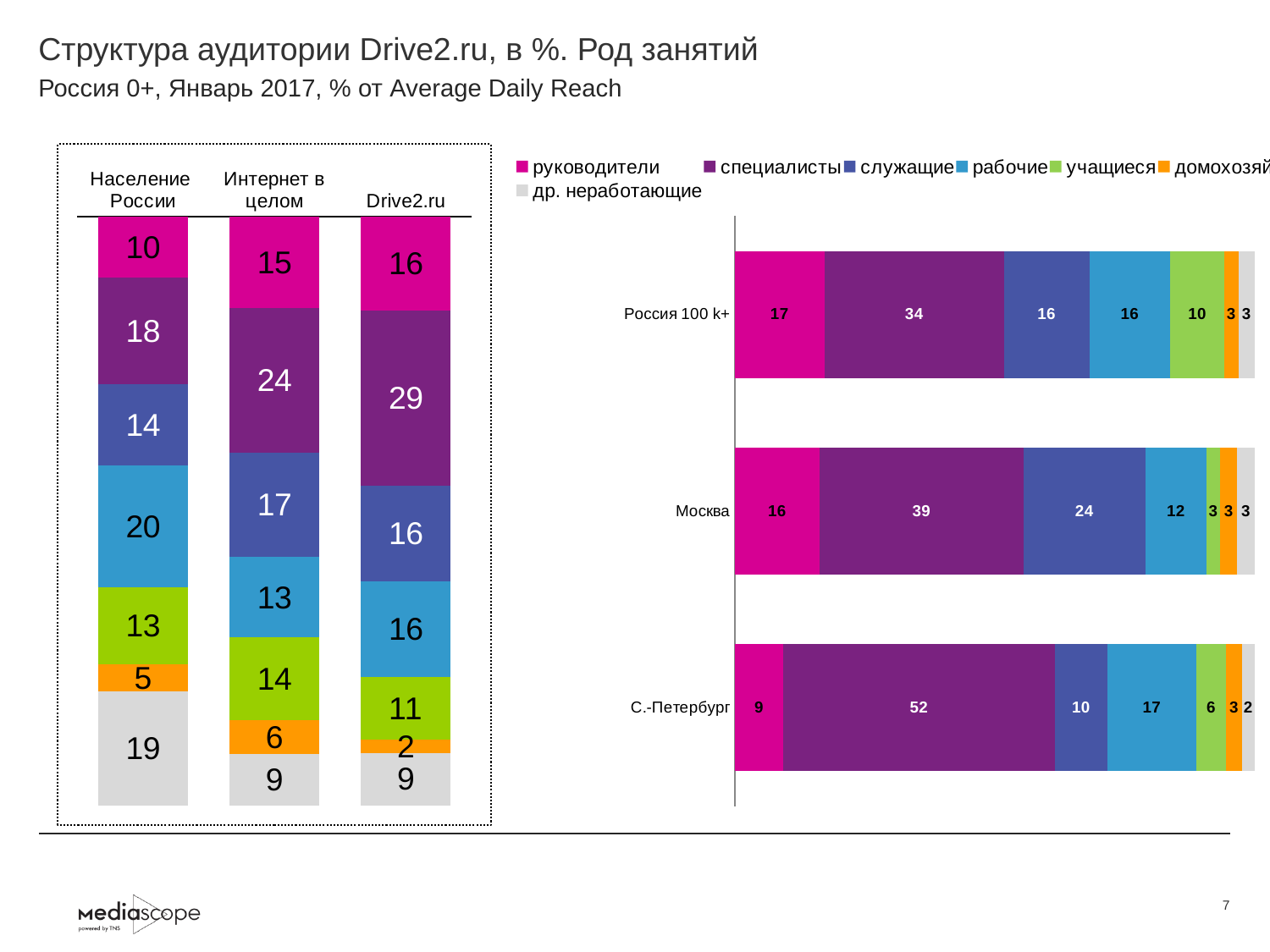
In the right-hand chart, what is the value of специалисты for С.-Петербург? 52 In the right-hand chart, what is the value of служащие for Москва? 24 In the right-hand chart, which region has the highest value for специалисты? С.-Петербург In the left-hand chart, what is the value of the специалисты (purple) segment for Drive2.ru? 29 In the right-hand chart, what is the value of руководители for Россия 100 k+? 17 What kind of chart is the right-hand chart? Stacked bar chart In the left-hand chart, what is the value of the bottom grey (др. неработающие) segment for Население России? 19 In the right-hand chart, what is the difference between the специалисты values for С.-Петербург and Россия 100 k+? 18 In the left-hand chart, which is larger: the рабочие (blue) value for Население России or for Drive2.ru? Население России How many bars are shown in the left-hand chart? 3 How many series does the legend of the right-hand chart list? 7 In the right-hand chart, which region has the lowest value for руководители? С.-Петербург